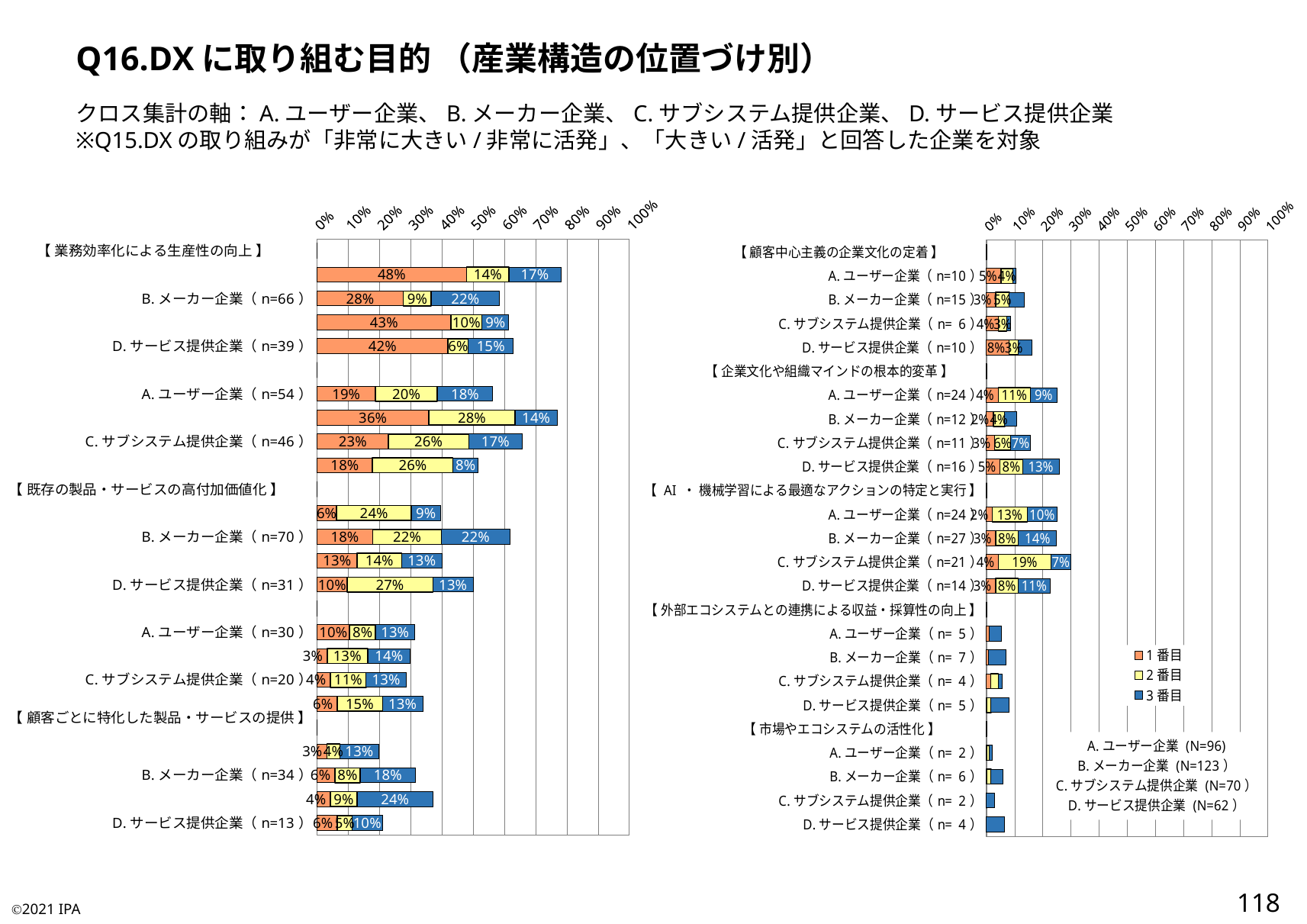
On the left chart, what is the 3番目 value for D. サービス提供企業 (n=39)? 15% On the left chart, what is the 2番目 value for A. ユーザー企業 (n=54)? 20% On the left chart, what is the 2番目 value for D. サービス提供企業 (n=31)? 27% What kind of chart is the left chart? Stacked bar chart On the right chart, what is the 2番目 value for C. サブシステム提供企業 (n=21)? 19% On the right chart, what is the 3番目 value for B. メーカー企業 (n=27)? 14% On the left chart, what is the total of the stacked bar for C. サブシステム提供企業 (n=46)? 66% On the left chart, what is the 1番目 value for B. メーカー企業 (n=66)? 28% How many series does the legend on the right chart list? 3 On the left chart, what is the difference between the 1番目 values of D. サービス提供企業 (n=39) and B. メーカー企業 (n=66)? 14% On the left chart, which has the larger 3番目 value: B. メーカー企業 (n=70) or D. サービス提供企業 (n=31)? B. メーカー企業 (n=70) On the right chart, what is the 3番目 value for D. サービス提供企業 (n=16)? 13%